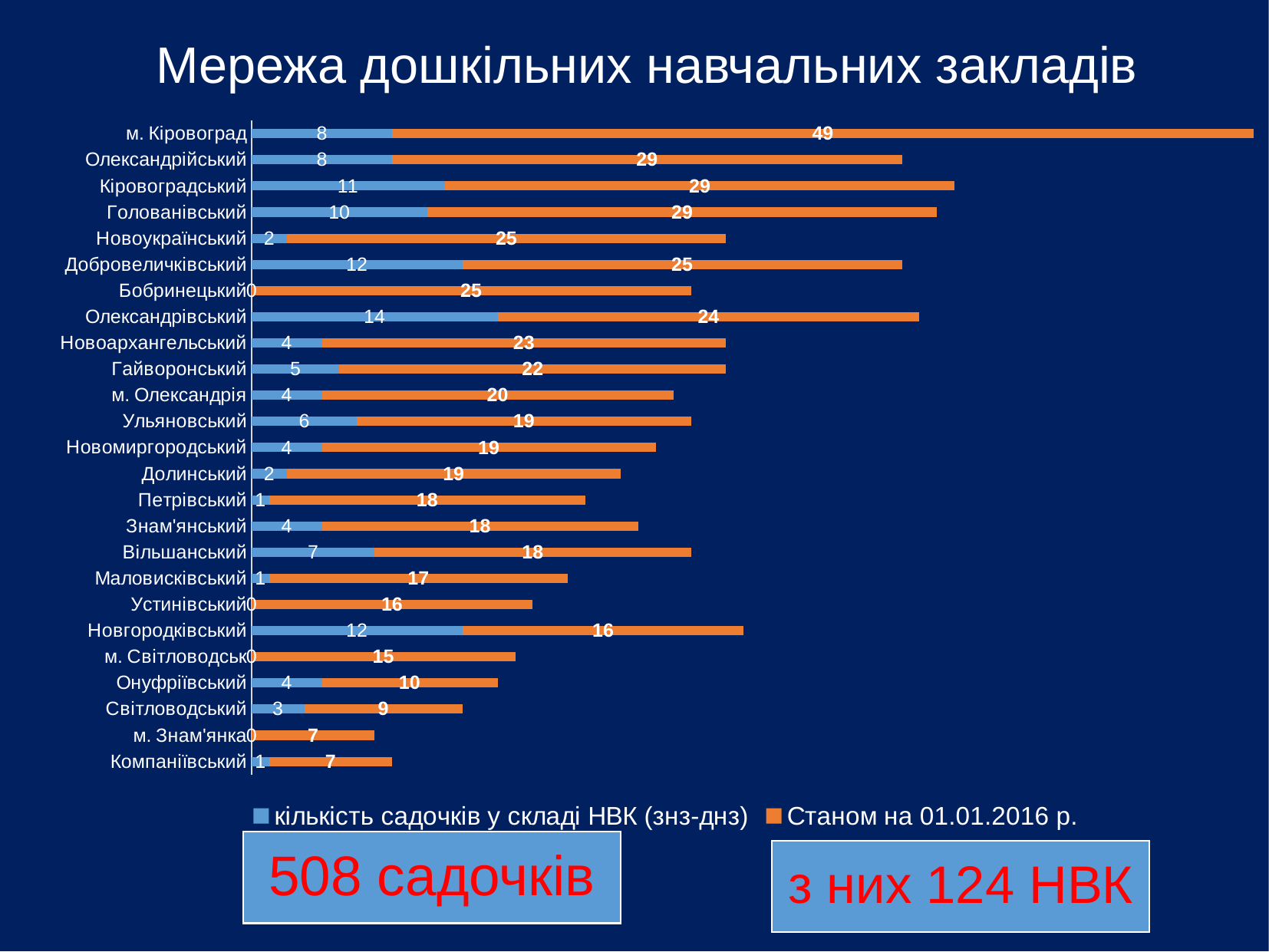
What is the value of the 'Станом на 01.01.2016 р.' series for м. Кіровоград? 49 Which category has the highest value in the 'кількість садочків у складі НВК (знз-днз)' series? Олександрівський What kind of chart is shown on the slide? bar chart What is the difference between the 'Станом на 01.01.2016 р.' values for м. Кіровоград and Олександрійський? 20 What is the value of the 'кількість садочків у складі НВК (знз-днз)' series for Олександрівський? 14 What is the title of the chart? Мережа дошкільних навчальних закладів What is the total of the stacked bar for м. Кіровоград? 57 How many series does the legend list? 2 Which category has the highest value in the 'Станом на 01.01.2016 р.' series? м. Кіровоград Which is larger: the 'Станом на 01.01.2016 р.' value for Гайворонський or for Онуфріївський? Гайворонський How many categories (districts/cities) are plotted on the chart? 25 What is the value of the 'Станом на 01.01.2016 р.' series for Новгородківський? 16